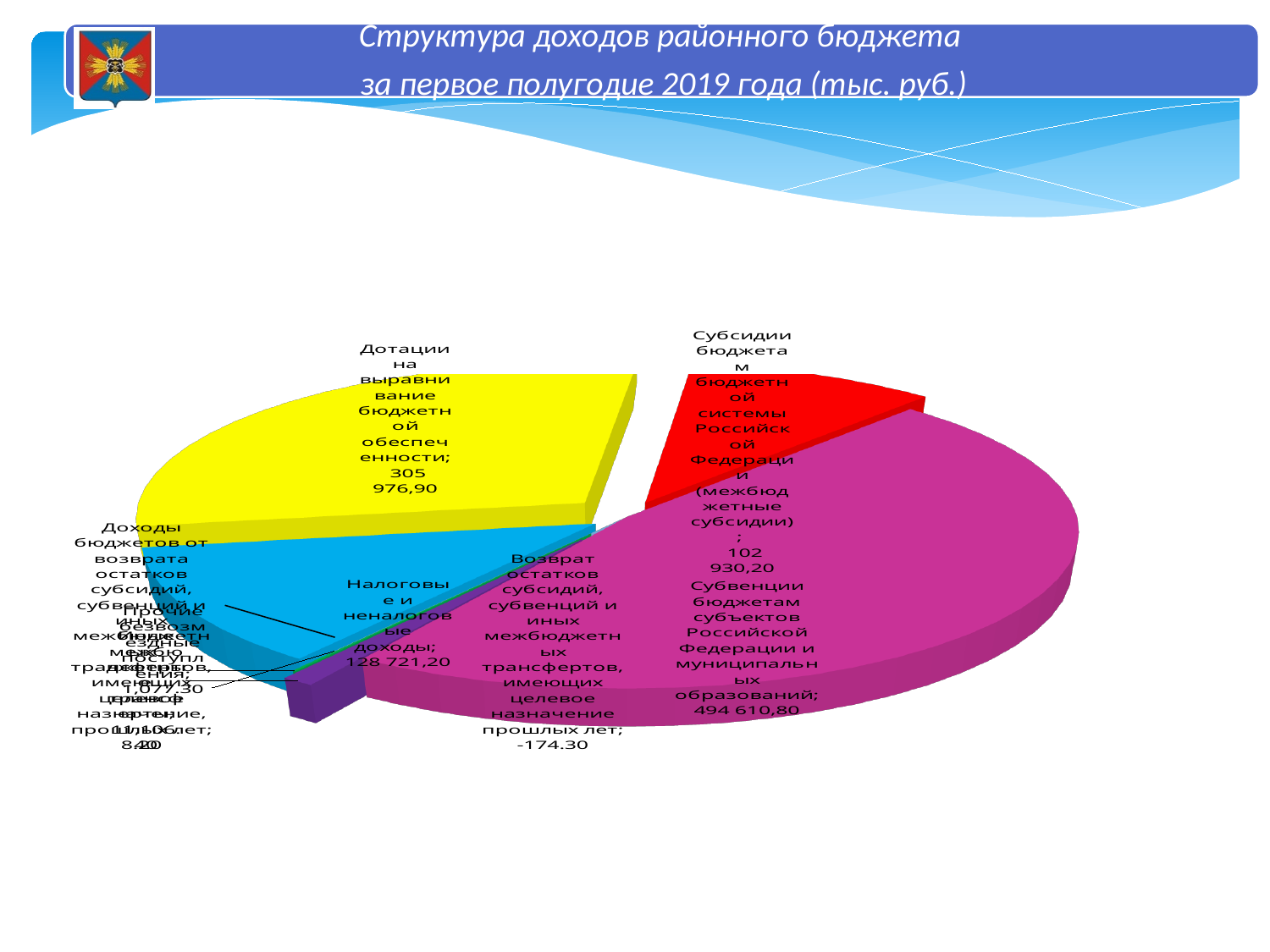
Which is larger: Дотации на выравнивание бюджетной обеспеченности or Налоговые и неналоговые доходы? Дотации на выравнивание бюджетной обеспеченности What kind of chart is shown on the slide? Pie chart What is the value for Субвенции бюджетам субъектов Российской Федерации и муниципальных образований? 494 610,80 Which category has the largest slice of the pie? Субвенции бюджетам субъектов Российской Федерации и муниципальных образований What is the difference between Налоговые и неналоговые доходы and Субсидии бюджетам бюджетной системы Российской Федерации? 25 791,00 What is the value for Субсидии бюджетам бюджетной системы Российской Федерации (межбюджетные субсидии)? 102 930,20 What is the title of the chart on the slide? Структура доходов районного бюджета за первое полугодие 2019 года (тыс. руб.) What is the difference between Субвенции (494 610,80) and Дотации на выравнивание бюджетной обеспеченности (305 976,90)? 188 633,90 What is the value for Налоговые и неналоговые доходы? 128 721,20 What is the value for Дотации на выравнивание бюджетной обеспеченности? 305 976,90 Which is larger: Налоговые и неналоговые доходы or Субсидии бюджетам бюджетной системы Российской Федерации? Налоговые и неналоговые доходы What is the value for Возврат остатков субсидий, субвенций и иных межбюджетных трансфертов, имеющих целевое назначение, прошлых лет? -174.30